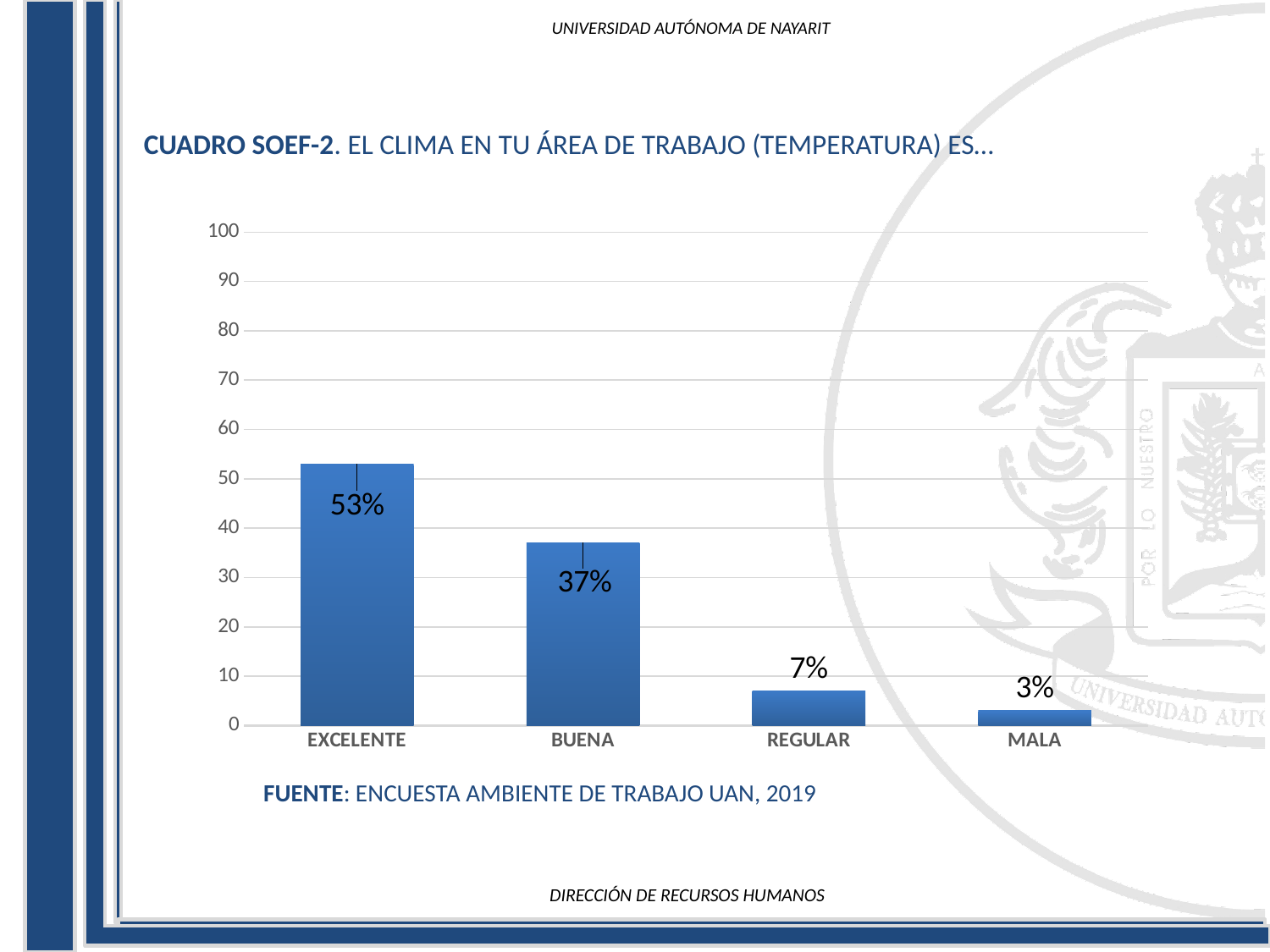
What is the value for MALA? 3% Which category has the lowest value? MALA What is the value for EXCELENTE? 53% Which category has the highest value? EXCELENTE What is the value for REGULAR? 7% What is the value for BUENA? 37% Is the value for EXCELENTE greater or less than 50? greater What kind of chart is shown on the slide? bar chart Do the values rise or fall from left to right along the x axis? fall What is the difference between the values for EXCELENTE and BUENA? 16% How many categories are shown on the x axis? 4 Which is larger, the value for REGULAR or the value for MALA? REGULAR